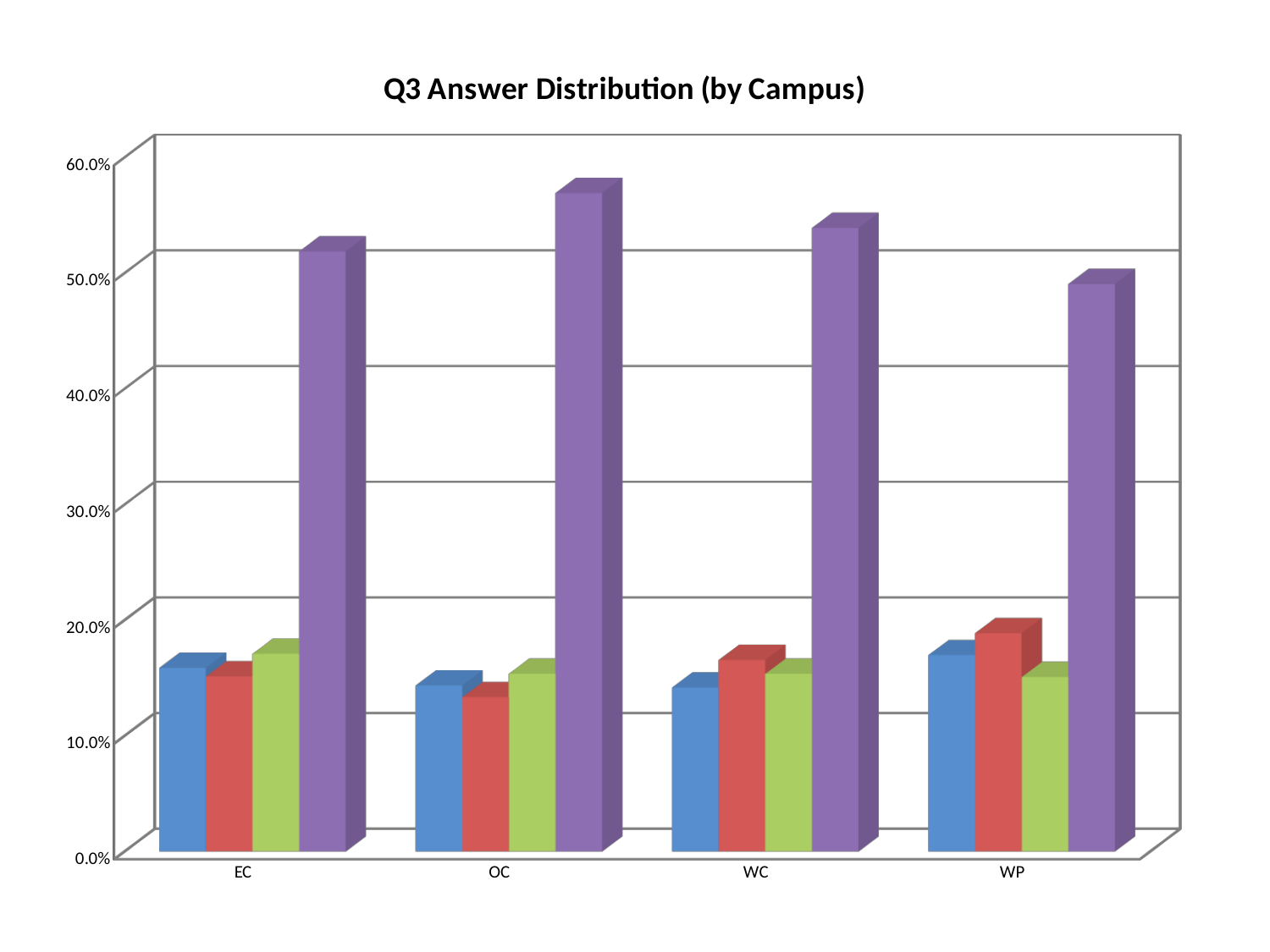
What colour are the tallest bars in each campus group? purple Is the blue bar for WC greater or less than 10.0%? greater How many campus categories are shown on the x axis? 4 How many bars are plotted for each campus? 4 Is the purple bar for OC greater or less than 50.0%? greater Which campus has the shortest purple bar? WP What is the title of the chart? Q3 Answer Distribution (by Campus) Is the purple bar for WP greater or less than 40.0%? greater Which campus has the tallest purple bar? OC What kind of chart is shown on the slide? bar chart Which is larger, the red bar for WP or the red bar for OC? WP